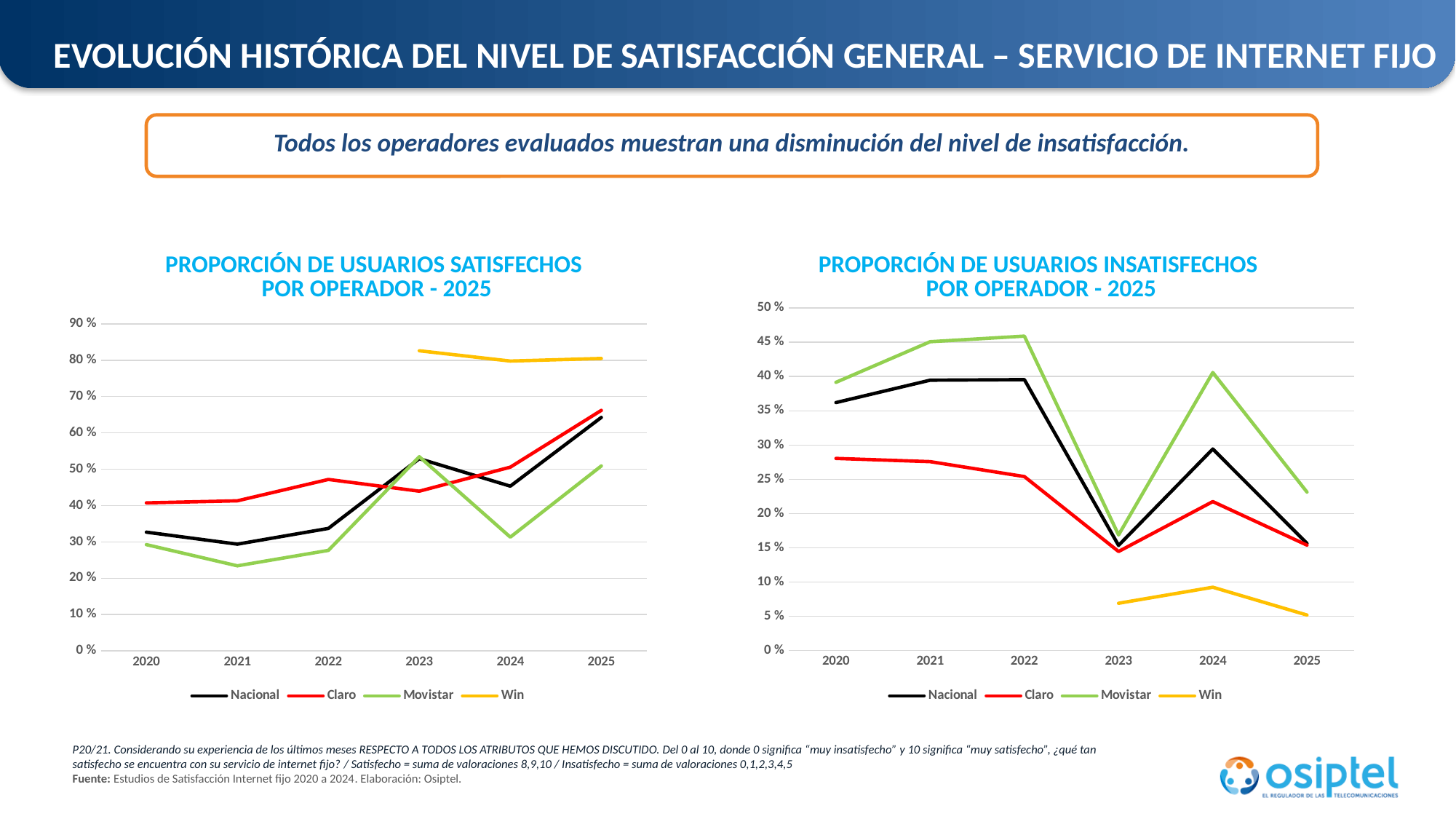
How many series does the legend of the left chart, 'Proporción de usuarios satisfechos por operador - 2025', list? 4 In the left chart, 'Proporción de usuarios satisfechos por operador - 2025', is the value for Movistar in 2021 greater or less than 30 %? less In the left chart, 'Proporción de usuarios satisfechos por operador - 2025', which operator has the lowest value in 2025? Movistar How many years are shown on the x axis of the right chart, 'Proporción de usuarios insatisfechos por operador - 2025'? 6 In the left chart, 'Proporción de usuarios satisfechos por operador - 2025', which operator has the highest value in 2025? Win In the left chart, 'Proporción de usuarios satisfechos por operador - 2025', is the value for Win in 2023 greater or less than 80 %? greater In the right chart, 'Proporción de usuarios insatisfechos por operador - 2025', which operator has the highest value in 2024? Movistar What kind of chart is the left chart, 'Proporción de usuarios satisfechos por operador - 2025'? Line chart In the right chart, 'Proporción de usuarios insatisfechos por operador - 2025', is the value for Win in 2025 greater or less than 10 %? less In the right chart, 'Proporción de usuarios insatisfechos por operador - 2025', does the Claro line rise or fall overall from 2020 to 2025? Fall In the right chart, 'Proporción de usuarios insatisfechos por operador - 2025', which is larger in 2022: Movistar or Claro? Movistar